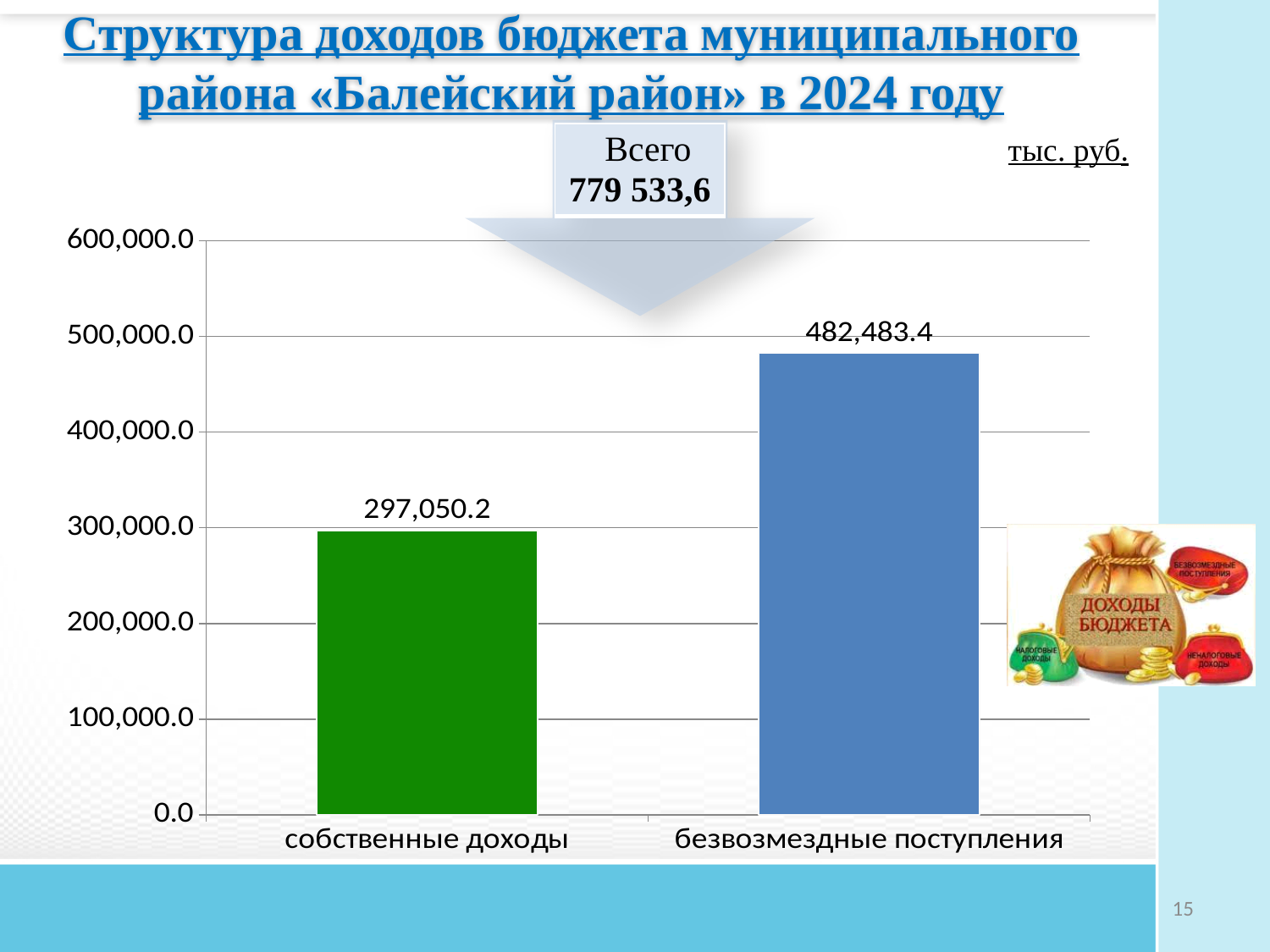
Is the value for безвозмездные поступления greater or less than 400,000.0? greater Which category has the highest value? безвозмездные поступления What is the difference between безвозмездные поступления and собственные доходы? 185,433.2 Which category has the lowest value? собственные доходы Is the value for собственные доходы greater or less than 300,000.0? less Which is larger, собственные доходы or безвозмездные поступления? безвозмездные поступления What is the value for безвозмездные поступления? 482,483.4 What total (Всего) is shown above the chart? 779 533,6 What is the value for собственные доходы? 297,050.2 What colour is the bar for собственные доходы? green What kind of chart is shown on the slide? bar chart How many categories are shown in the chart? 2